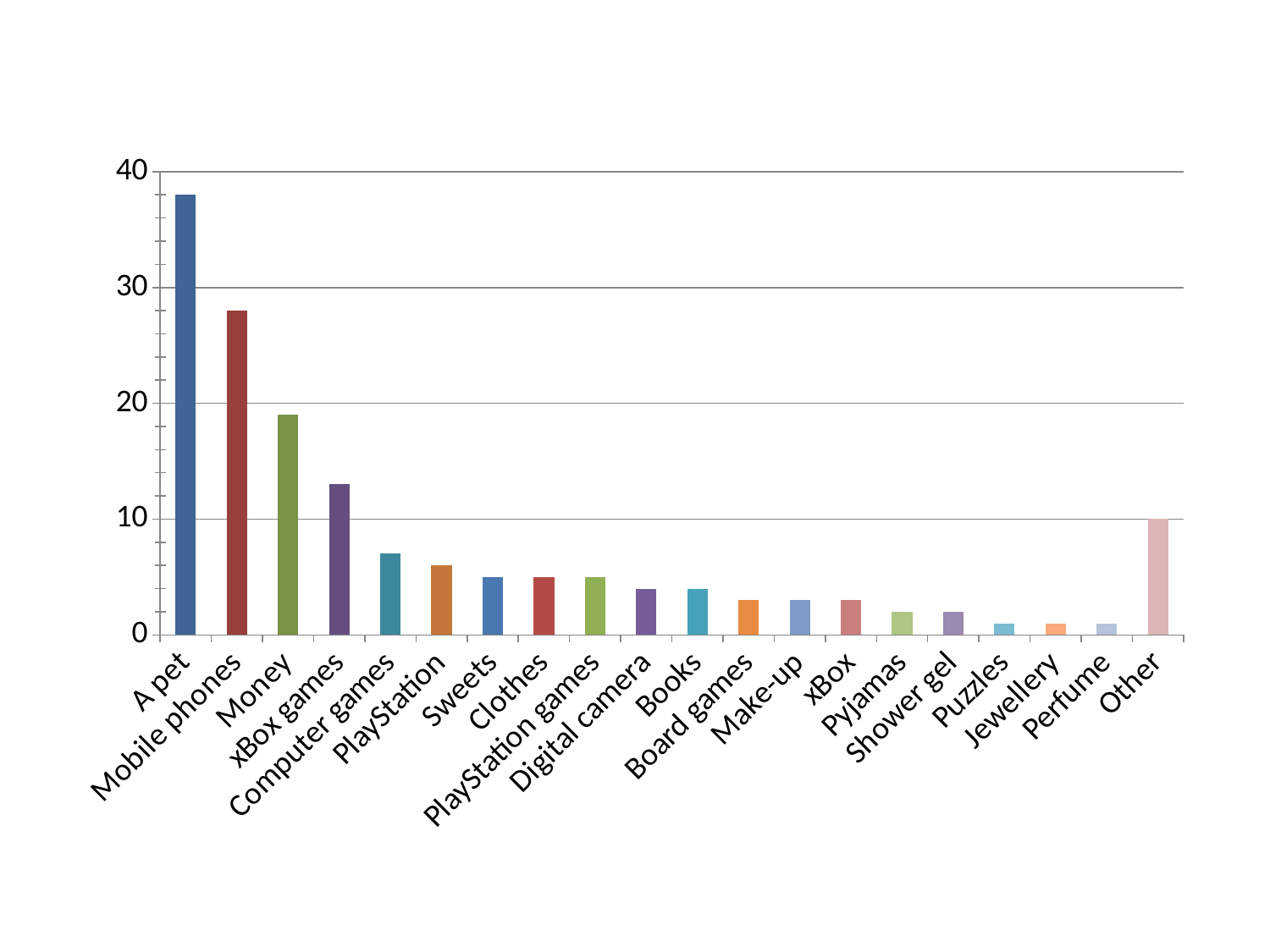
What kind of chart is shown on the slide? bar chart Is the value for Mobile phones greater or less than 30? less Which is larger, the value for Money or the value for Other? Money Which category has the highest bar in the chart? A pet Is the value for xBox games greater or less than 10? greater Which is larger, the value for A pet or the value for Mobile phones? A pet What is the value for Other in the chart? 10 Is the value for Money greater or less than 20? less Which is larger, the value for Books or the value for Puzzles? Books How many categories are shown on the x axis of the chart? 20